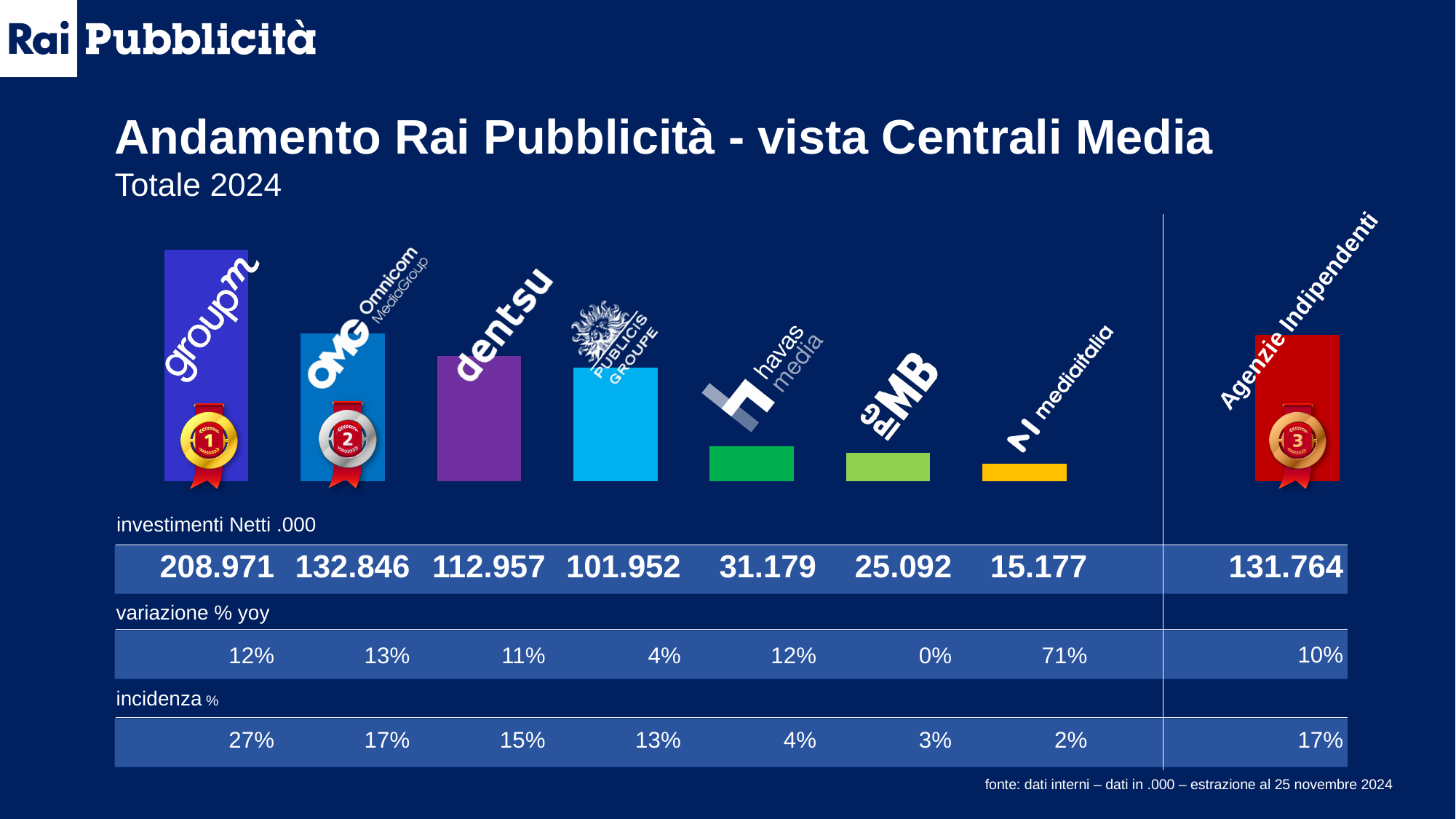
What is the net investment (investimenti Netti .000) for GroupM? 208.971 What is the variazione % yoy for Mediaitalia? 71% What is the subtitle shown under the chart title? Totale 2024 What kind of chart is shown on the slide? bar chart How many bars (media agencies/groups) are shown in the chart? 8 Which agency has the highest net investment? GroupM What is the incidenza % for Havas Media? 4% Which agency has the lowest net investment? Mediaitalia What is the net investment (investimenti Netti .000) for Dentsu? 112.957 What is the net investment (investimenti Netti .000) for Agenzie Indipendenti? 131.764 What is the difference in net investment between GroupM and Omnicom Media Group? 76.125 Which has a higher net investment, Dentsu or Publicis Groupe? Dentsu